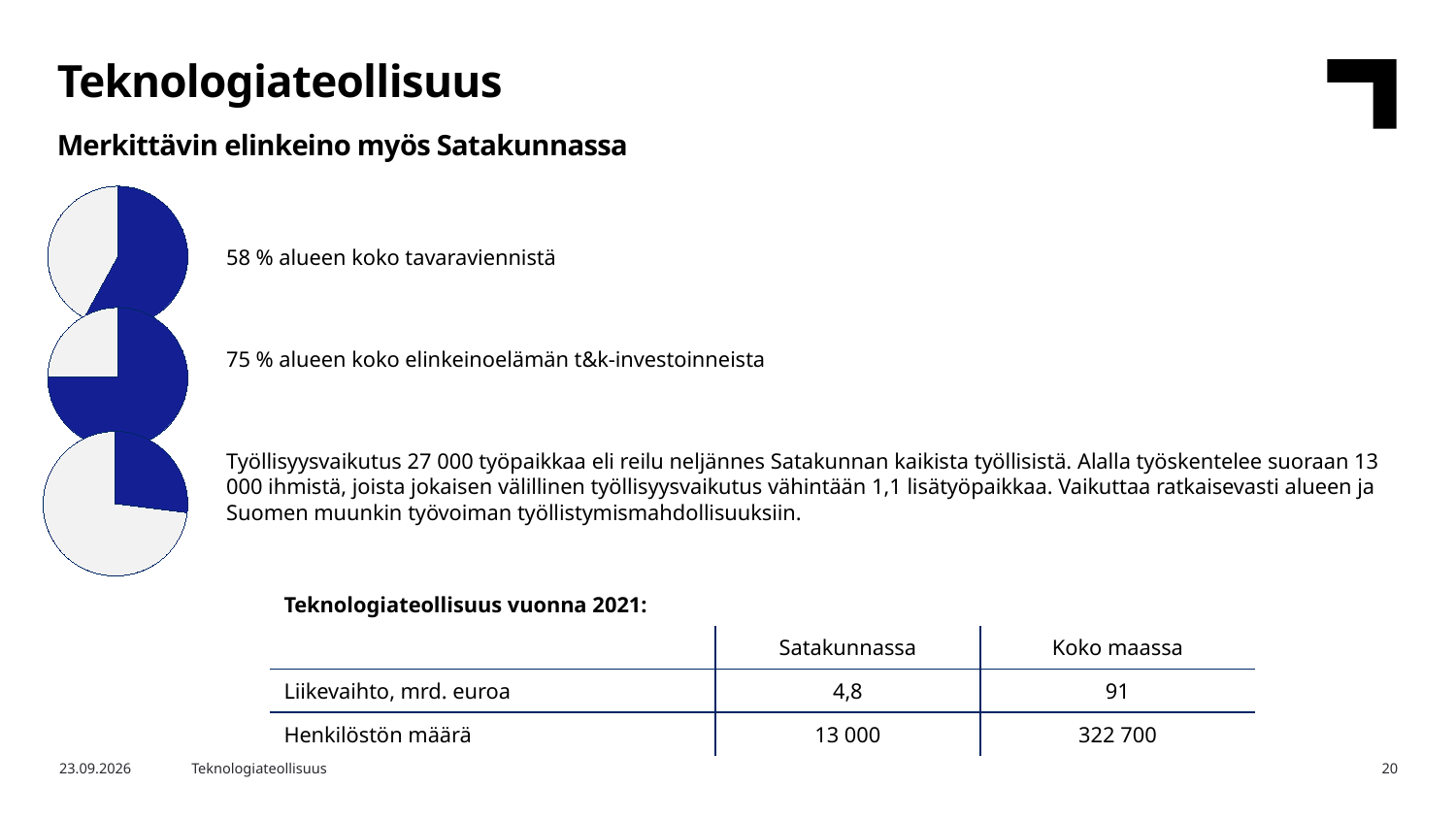
Is the blue slice of the top pie chart larger or smaller than the blue slice of the bottom pie chart? larger What kind of charts are the three charts on the left side of the slide? pie charts In the top pie chart, what share does the blue slice represent according to the text beside it? 58 % By how many percentage points does the blue share of the middle pie chart (75 %) exceed the blue share of the top pie chart (58 %)? 17 Is the blue slice of the bottom pie chart greater or less than half of the pie? less What does the top pie chart represent, according to the text next to it? 58 % alueen koko tavaraviennistä What colour is the highlighted slice in each of the pie charts? blue How many pie charts are shown on the slide? 3 Which of the three pie charts has the smallest blue slice? the bottom pie chart Is the blue slice of the middle pie chart greater or less than half of the pie? greater Which of the three pie charts has the largest blue slice? the middle pie chart In the middle pie chart, what share does the blue slice represent according to the text beside it? 75 %